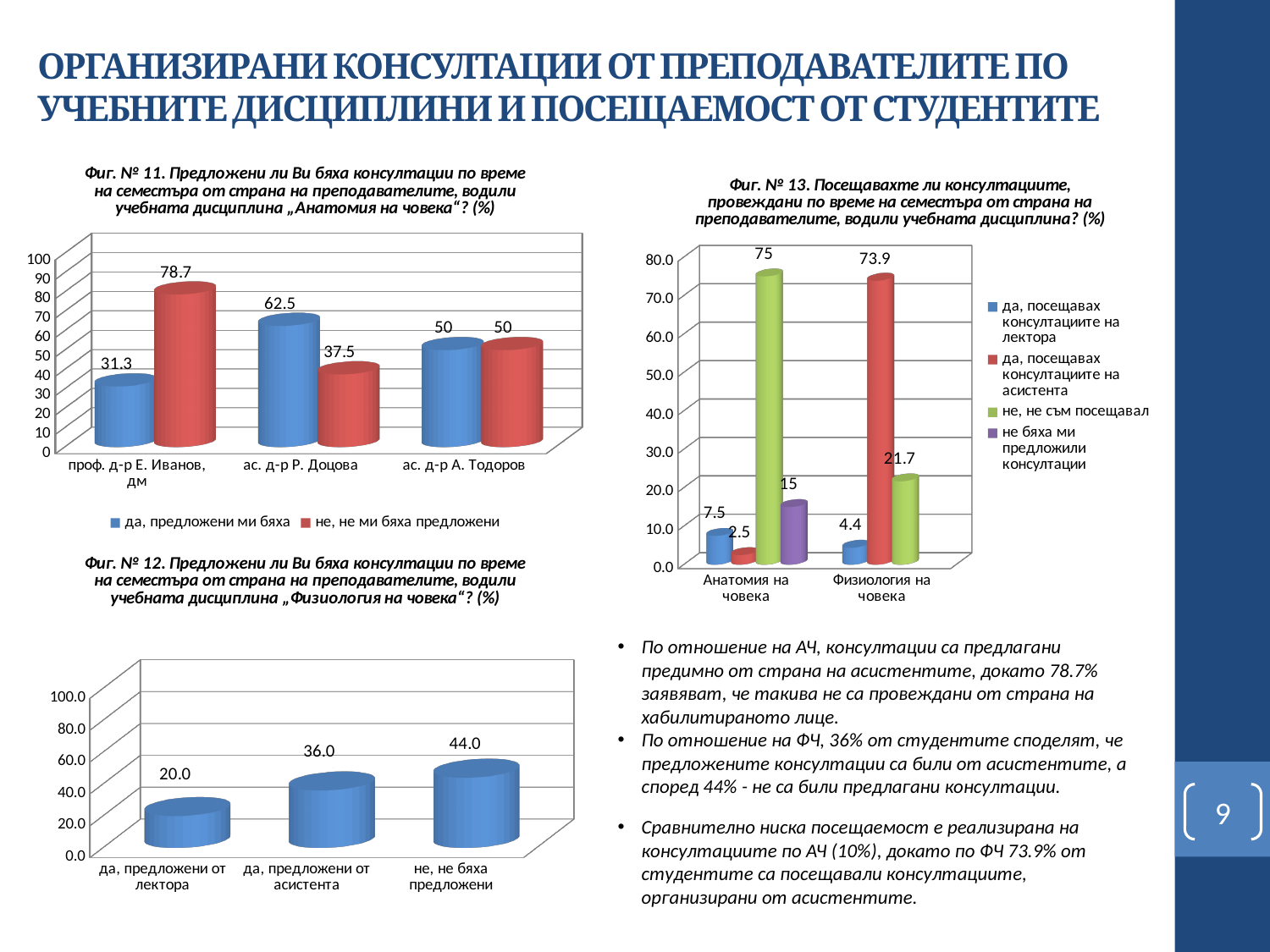
In the chart 'Фиг. № 11', what is the value of 'да, предложени ми бяха' for 'проф. д-р Е. Иванов, дм'? 31.3 In the chart 'Фиг. № 13', what is the value of 'не, не съм посещавал' for 'Анатомия на човека'? 75 In the chart 'Фиг. № 12', what is the value for 'да, предложени от асистента'? 36.0 In the chart 'Фиг. № 11', what is the value of 'не, не ми бяха предложени' for 'ас. д-р Р. Доцова'? 37.5 In the chart 'Фиг. № 12', what kind of chart is shown? bar chart In the chart 'Фиг. № 12', which category has the highest value? не, не бяха предложени In the chart 'Фиг. № 13', what is the value of 'да, посещавах консултациите на асистента' for 'Физиология на човека'? 73.9 In the chart 'Фиг. № 11', how many series does the legend list? 2 In the chart 'Фиг. № 11', what is the difference between the two values for 'проф. д-р Е. Иванов, дм'? 47.4 In the chart 'Фиг. № 13', which is larger: 'да, посещавах консултациите на лектора' for 'Анатомия на човека' or for 'Физиология на човека'? Анатомия на човека In the chart 'Фиг. № 13', how many series does the legend list? 4 In the chart 'Фиг. № 12', do the values rise or fall from left to right along the x axis? rise